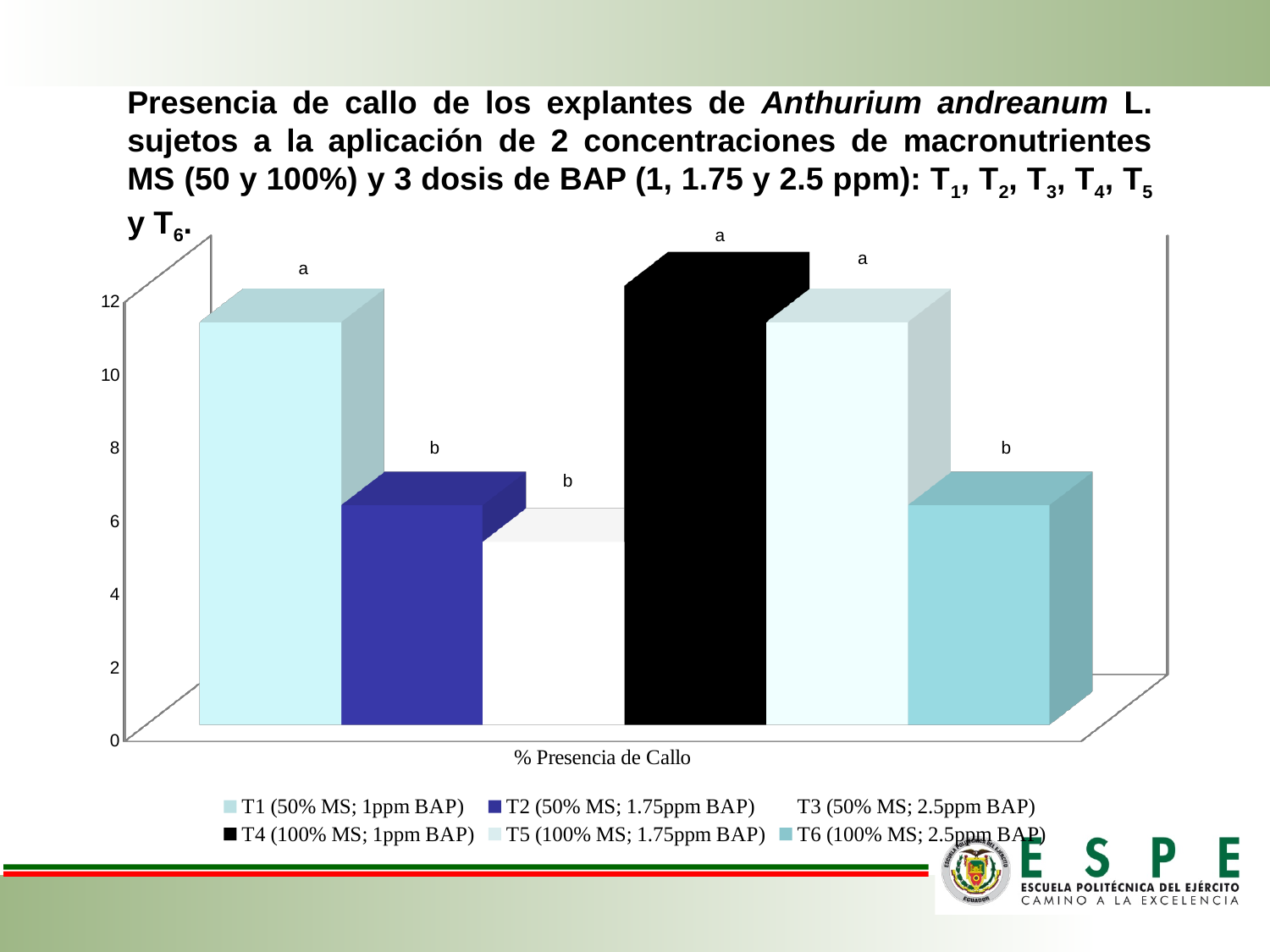
What kind of chart is shown on the slide? bar chart How many bars are plotted in the chart? 6 Which is larger, the value for T4 (100% MS; 1ppm BAP) or the value for T2 (50% MS; 1.75ppm BAP)? T4 (100% MS; 1ppm BAP) Is the value for T1 (50% MS; 1ppm BAP) greater or less than 8? greater Is the value for T4 (100% MS; 1ppm BAP) greater or less than 10? greater What letter is printed above the black bar for T4? a Is the value for T2 (50% MS; 1.75ppm BAP) greater or less than 8? less Which is larger, the value for T1 (50% MS; 1ppm BAP) or the value for T6 (100% MS; 2.5ppm BAP)? T1 (50% MS; 1ppm BAP) Which series has the tallest bar? T4 (100% MS; 1ppm BAP) What label is shown on the x axis below the bars? % Presencia de Callo How many series does the legend list? 6